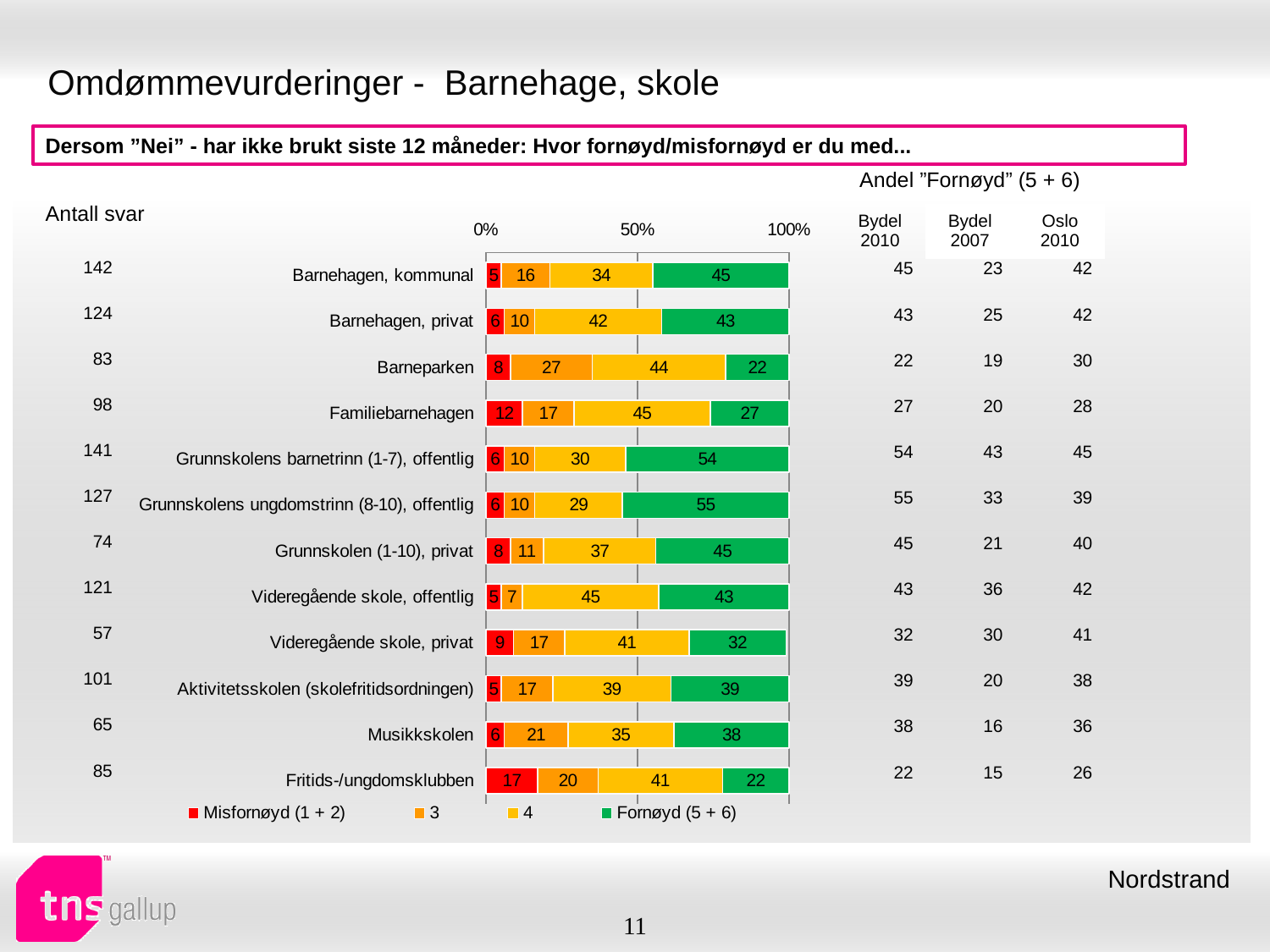
How many series does the chart legend list? 4 Which has a larger Fornøyd (5 + 6) value, Musikkskolen or Videregående skole, privat? Musikkskolen What is the Fornøyd (5 + 6) value for Grunnskolens barnetrinn (1-7), offentlig? 54 What is the value of series 4 for Barnehagen, privat? 42 What type of chart is shown on the slide? Stacked bar chart What is the Misfornøyd (1 + 2) value for Familiebarnehagen? 12 What is the value of series 3 for Barneparken? 27 Which category has the highest Fornøyd (5 + 6) value? Grunnskolens ungdomstrinn (8-10), offentlig What is the total of the stacked bar for Barnehagen, kommunal? 100 Which category has the highest Misfornøyd (1 + 2) value? Fritids-/ungdomsklubben How many categories are plotted in the chart? 12 What is the difference between the Fornøyd (5 + 6) values for Barnehagen, kommunal and Barneparken? 23